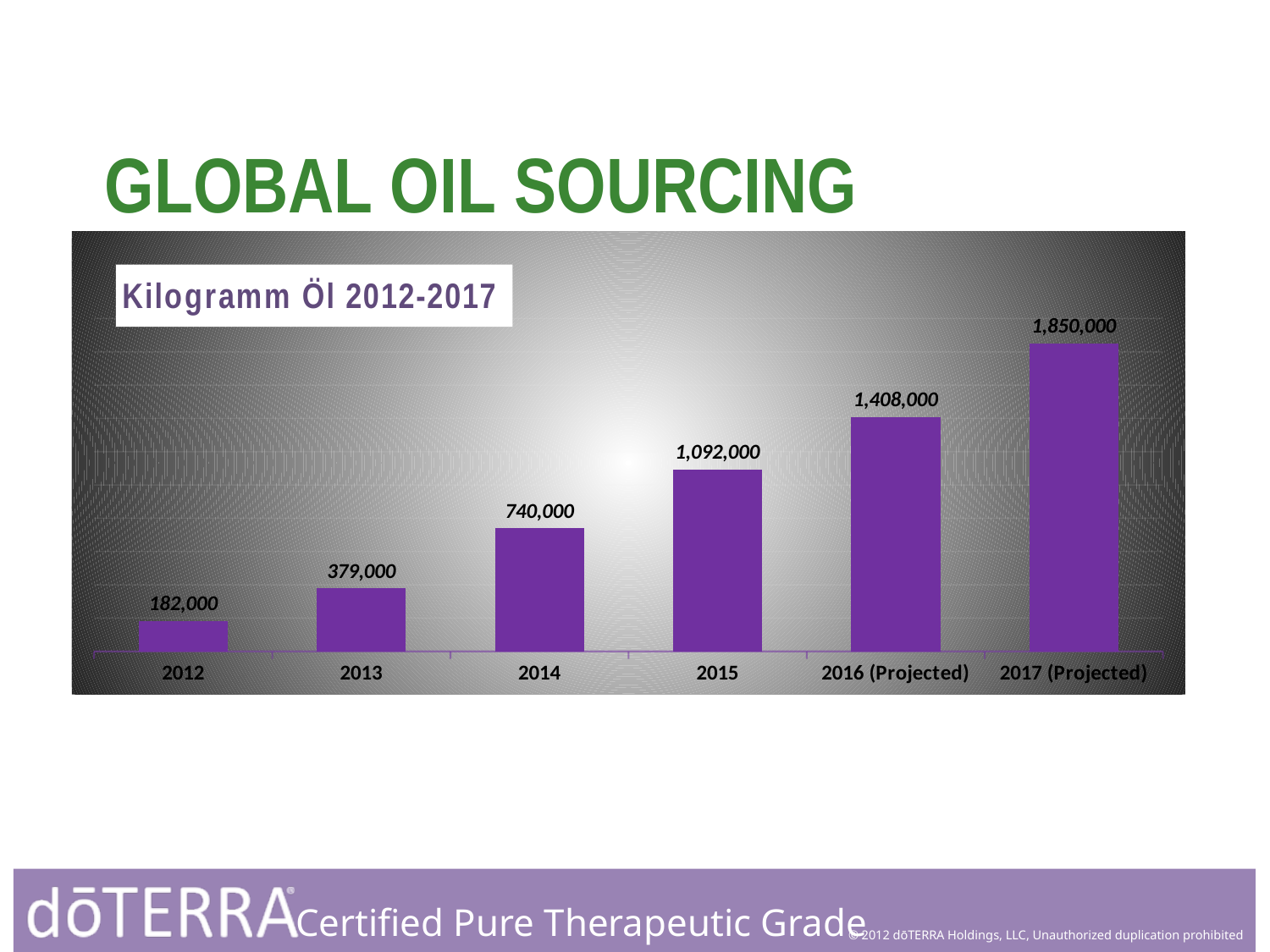
Do the values rise or fall from 2012 to 2017 (Projected)? rise What is the value for 2014? 740,000 What is the difference between the values for 2017 (Projected) and 2016 (Projected)? 442,000 What is the value for 2012? 182,000 Which is larger, the value for 2015 or the value for 2014? 2015 How many years are shown on the x axis? 6 What kind of chart is this? bar chart What is the difference between the values for 2013 and 2012? 197,000 What is the title of the chart? Kilogramm Öl 2012-2017 Which year has the lowest value? 2012 What is the value for 2016 (Projected)? 1,408,000 Which year has the highest value? 2017 (Projected)